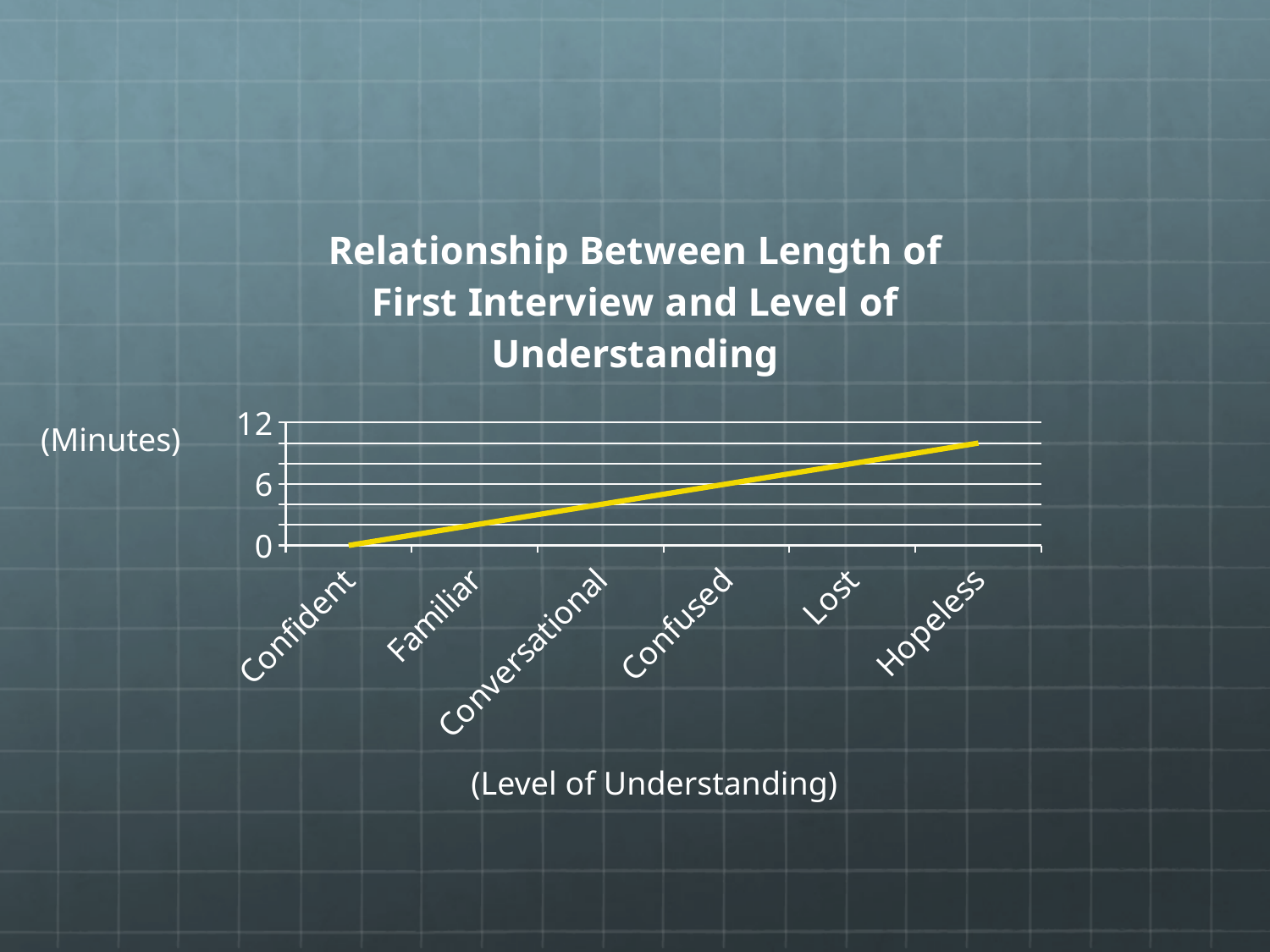
Is the value for Hopeless greater or less than 6? greater What is the title of the chart? Relationship Between Length of First Interview and Level of Understanding How many levels of understanding are plotted along the x axis? 6 Which level of understanding has the longest first interview? Hopeless Is the value for Familiar greater or less than 6? less Does the interview length rise or fall as the level of understanding moves from Confident to Hopeless? rise Which level of understanding has the shortest first interview? Confident Which has a longer first interview, Lost or Familiar? Lost What unit is shown for the vertical axis? Minutes Is the value for Lost greater or less than 6? greater What kind of chart is shown on the slide? line chart